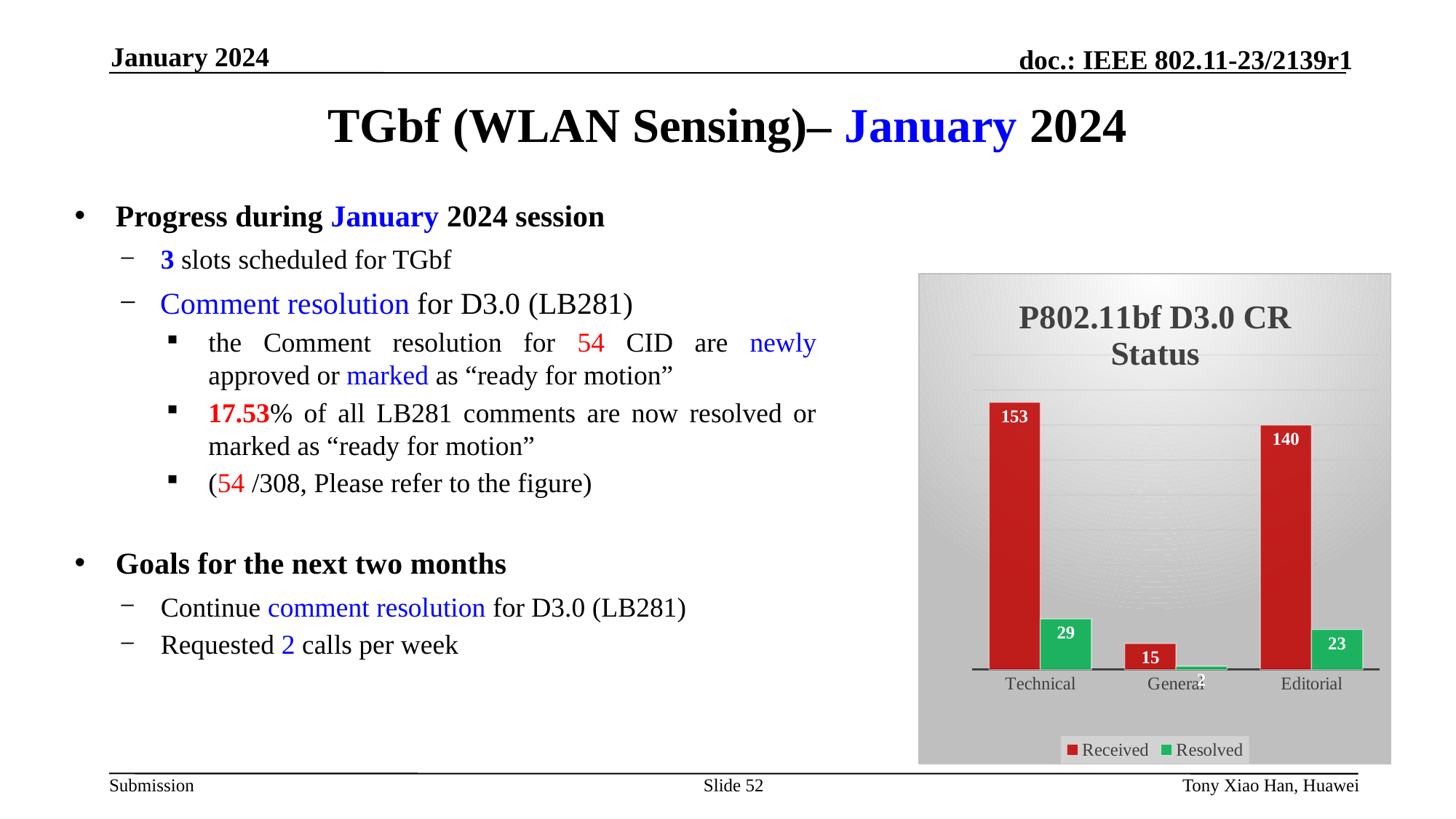
What is the Received value for Technical? 153 What is the Received value for General? 15 What is the title of the chart? P802.11bf D3.0 CR Status Which category has the highest Received value? Technical What is the difference between the Received and Resolved values for Technical? 124 What is the Resolved value for Editorial? 23 What is the difference between the Received values for Technical and Editorial? 13 Which category has the lowest Resolved value? General What kind of chart is shown on the slide? bar chart How many series does the chart legend list? 2 Which is larger, the Received value for Technical or the Received value for Editorial? Technical How many categories are shown on the x axis of the chart? 3